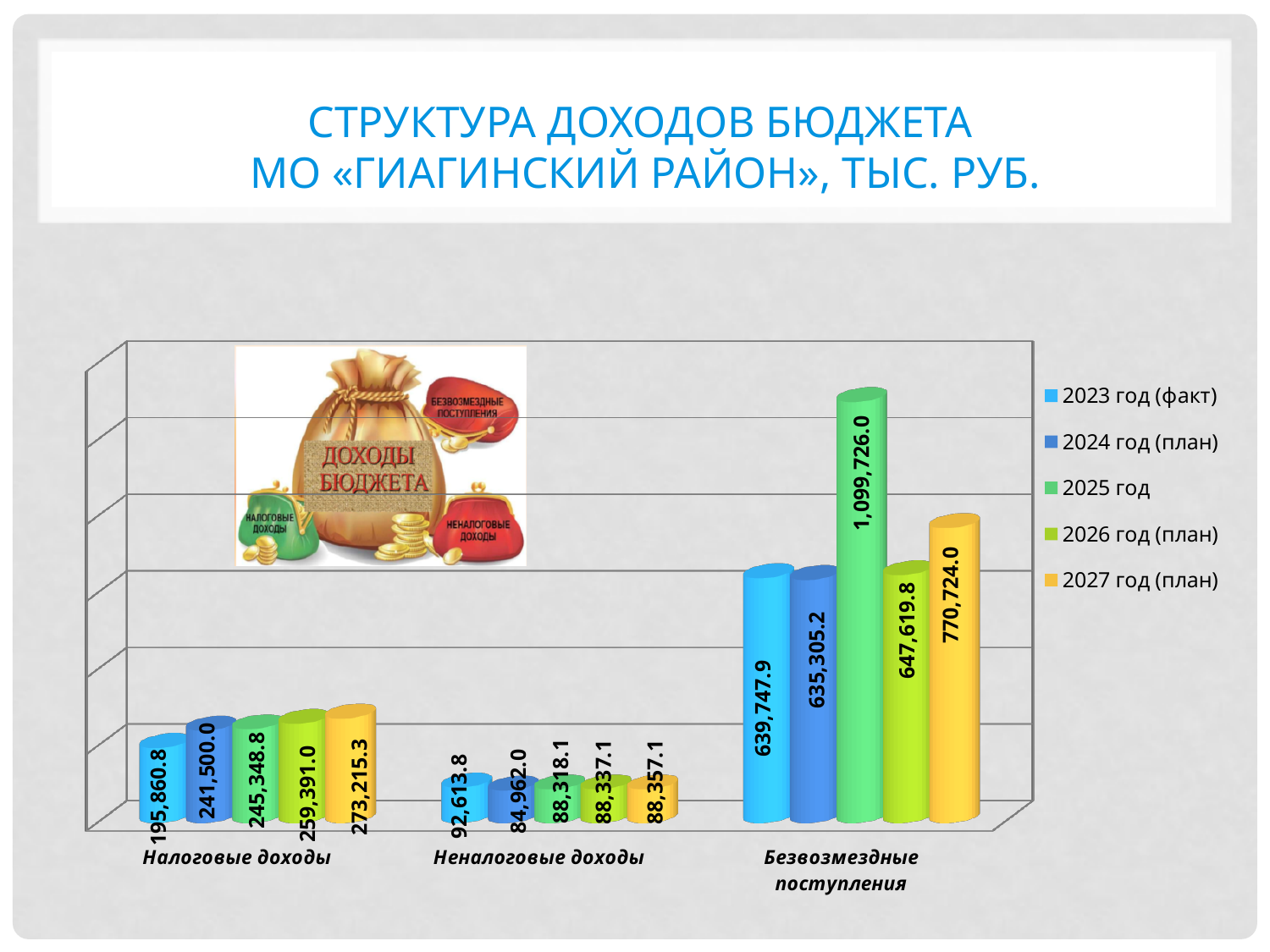
How many series does the legend list? 5 Which category has the lowest value in 2024 год (план)? Неналоговые доходы Do the values for Налоговые доходы rise or fall from 2023 год (факт) to 2027 год (план)? Rise How many categories are shown on the x axis? 3 What type of chart is shown on the slide? Bar chart What is the value for Безвозмездные поступления in 2025 год? 1,099,726.0 Which category has the highest value in 2026 год (план)? Безвозмездные поступления Which is larger for Безвозмездные поступления: the 2023 год (факт) value or the 2024 год (план) value? 2023 год (факт) What is the difference between the 2025 год and 2027 год (план) values for Безвозмездные поступления? 329,002.0 What is the difference between the 2027 год (план) and 2023 год (факт) values for Налоговые доходы? 77,354.5 What is the value for Налоговые доходы in 2023 год (факт)? 195,860.8 What is the value for Неналоговые доходы in 2027 год (план)? 88,357.1